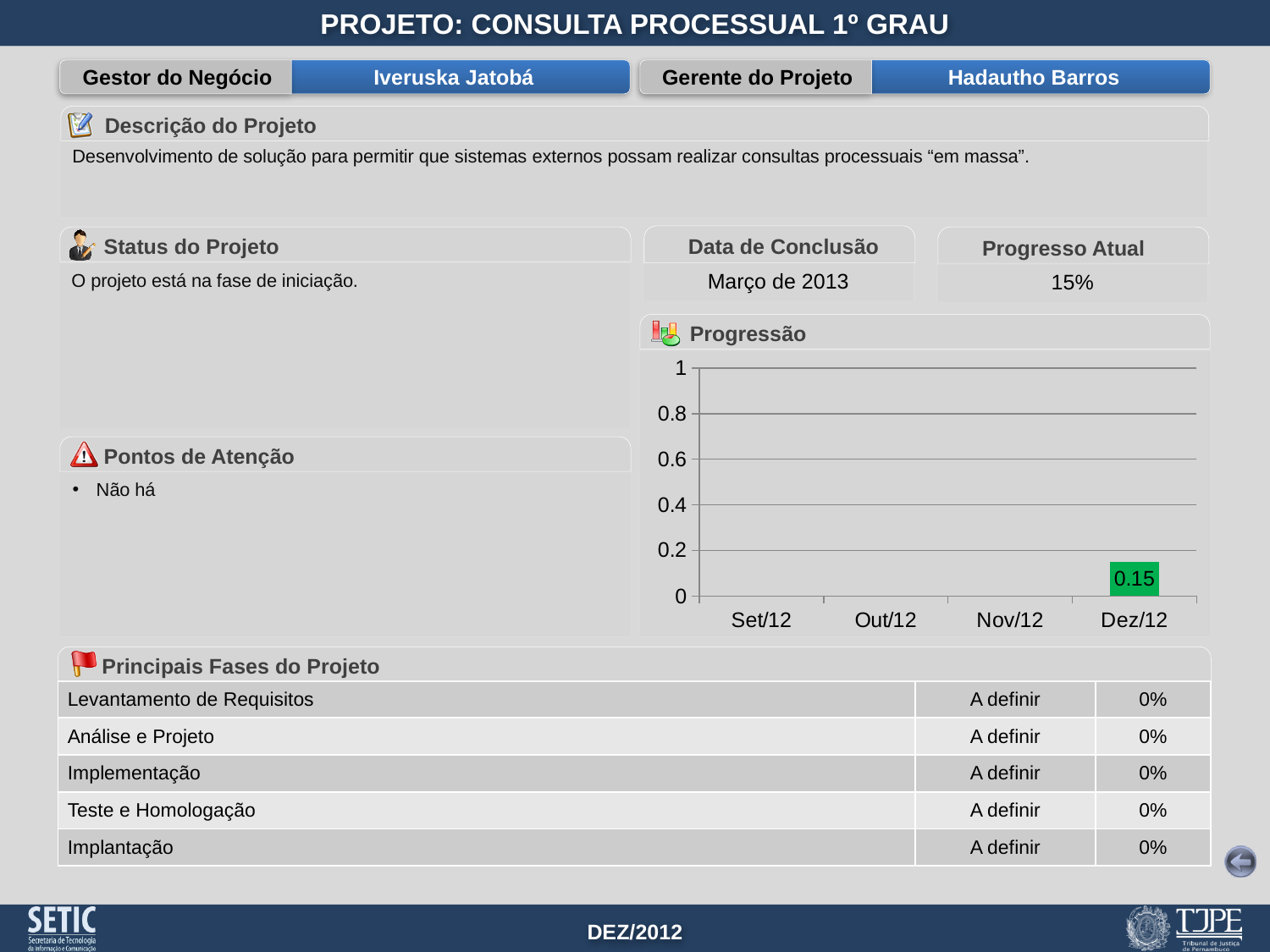
Which is the first category on the x axis of the Progressão chart? Set/12 How many categories are shown on the x axis of the Progressão chart? 4 In the Progressão chart, what is the value for Dez/12? 0.15 Which category in the Progressão chart has the highest value? Dez/12 In the Progressão chart, is the value for Dez/12 greater or less than 0.4? less What colour is the bar for Dez/12 in the Progressão chart? green What kind of chart is shown under "Progressão"? bar chart What is the highest value shown on the y axis of the Progressão chart? 1 In the Progressão chart, is the value for Dez/12 greater or less than 0.2? less